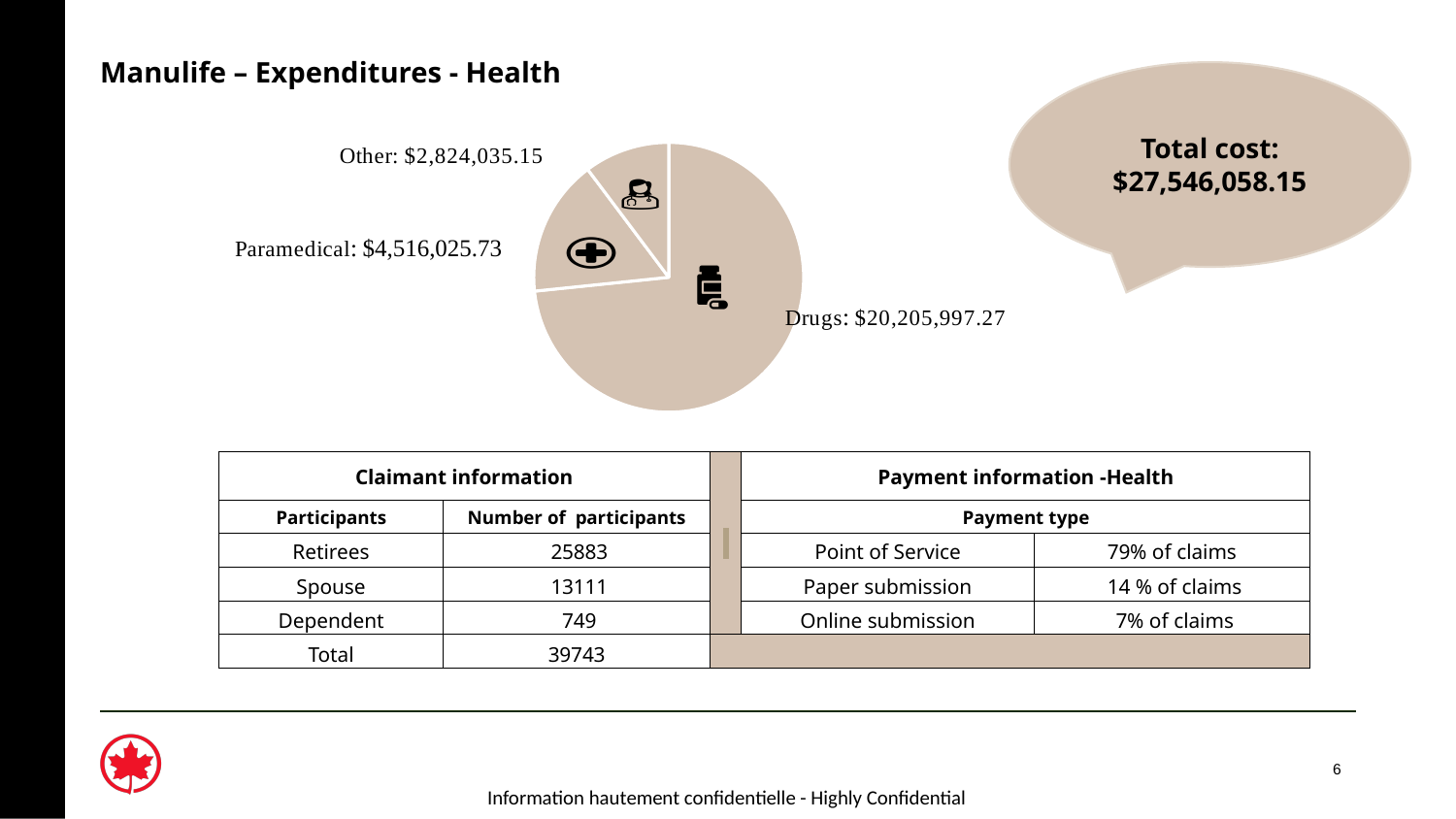
What is the difference between the Drugs value and the Paramedical value in the pie chart? $15,689,971.54 What is the value for Paramedical in the pie chart? $4,516,025.73 Which is larger in the pie chart, Paramedical or Other? Paramedical What kind of chart is shown on the slide? pie chart What is the value for Other in the pie chart? $2,824,035.15 What is the difference between the Paramedical value and the Other value in the pie chart? $1,691,990.58 What total cost is shown in the callout next to the pie chart? $27,546,058.15 What is the value for Drugs in the pie chart? $20,205,997.27 Which category has the smallest slice in the pie chart? Other Which category has the largest slice in the pie chart? Drugs How many slices does the pie chart have? 3 What is the total of the three slices in the pie chart? $27,546,058.15